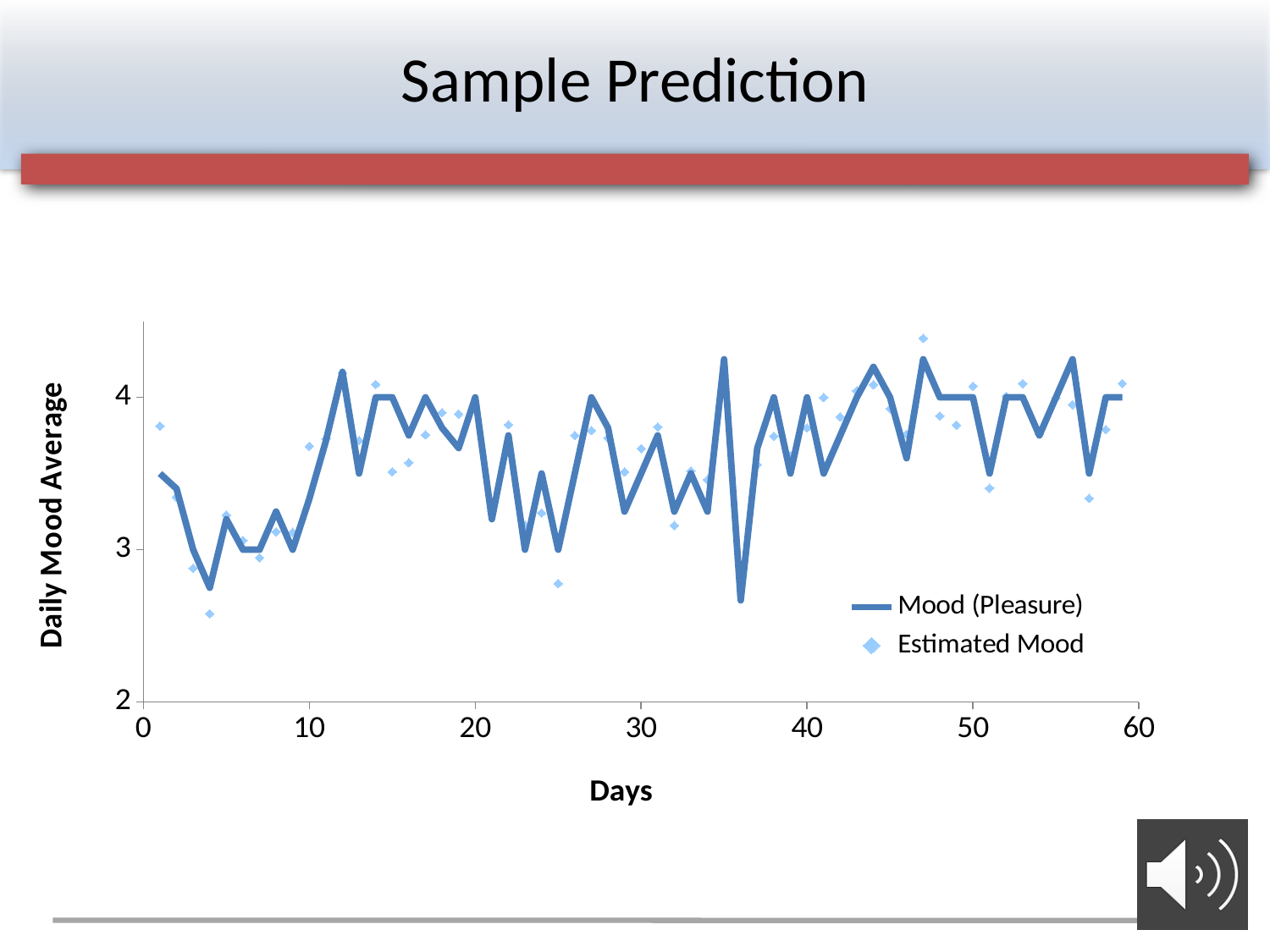
What is the label of the y axis? Daily Mood Average What kind of chart is shown on the slide? line chart How many series does the legend list? 2 Is the Estimated Mood value at day 25 greater or less than 3? less Is the Estimated Mood value at day 47 greater or less than 4? greater Is the Mood (Pleasure) value at day 36 greater or less than 3? less At which day does the Estimated Mood series reach its highest value? day 47 What are the two series named in the legend? Mood (Pleasure) and Estimated Mood At which day does the Estimated Mood series reach its lowest value? day 4 Does the Mood (Pleasure) line rise or fall between day 4 and day 12? rise